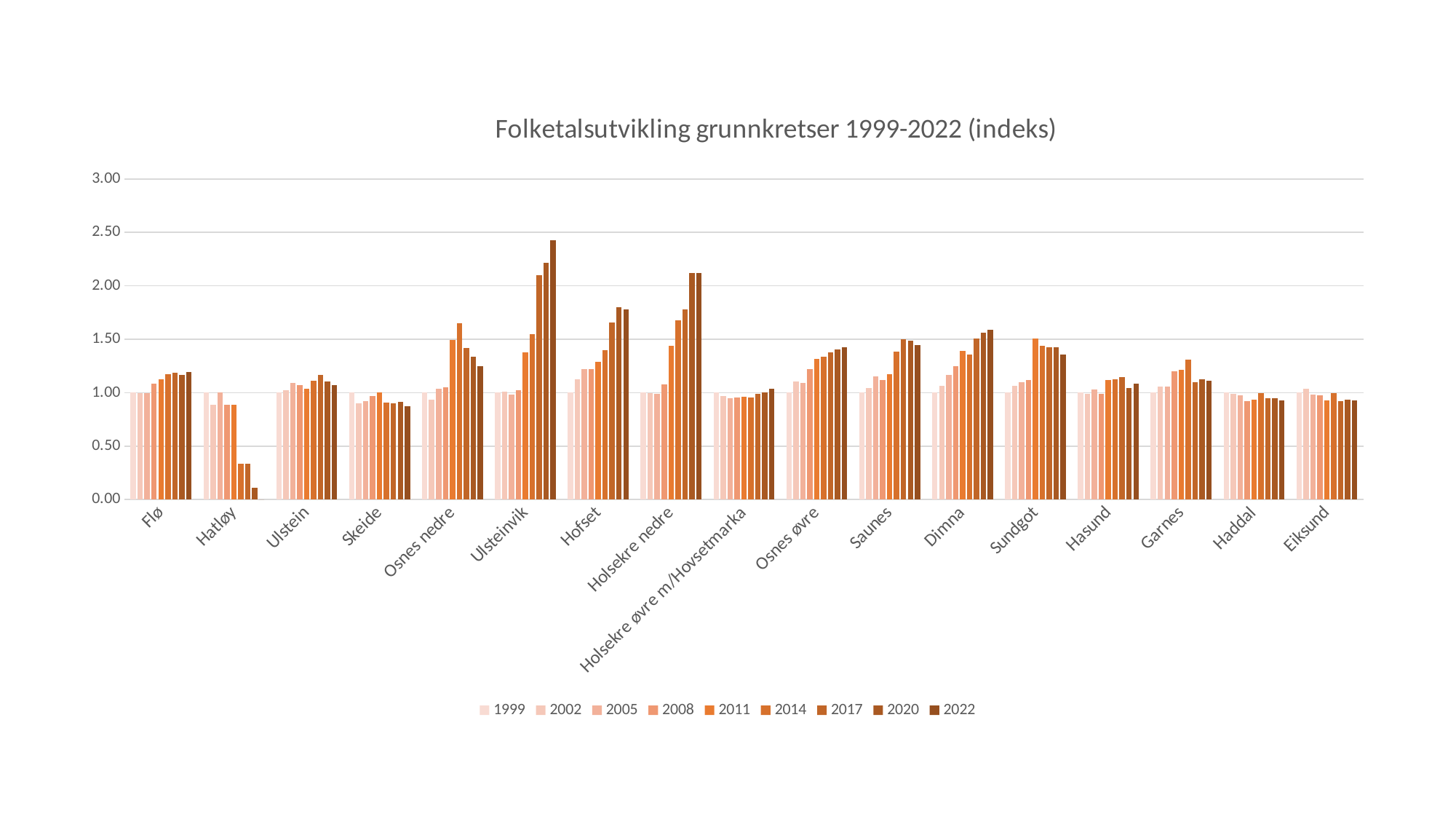
Is the value for Skeide in 2022 greater or less than 1.00? less Is the value for Ulsteinvik in 2022 greater or less than 2.00? greater Which is larger in 2022: the value for Ulsteinvik or the value for Hofset? Ulsteinvik Is the value for Hatløy in 2022 greater or less than 0.50? less Do the values for Hatløy rise or fall from 1999 to 2022? fall How many grunnkretser (categories) are shown on the x axis? 17 How many series (years) does the legend list? 9 Which grunnkrets has the highest bar in the chart? Ulsteinvik What is the title of the chart? Folketalsutvikling grunnkretser 1999-2022 (indeks) Which grunnkrets has the lowest bar in the chart? Hatløy What kind of chart is shown on the slide? bar chart